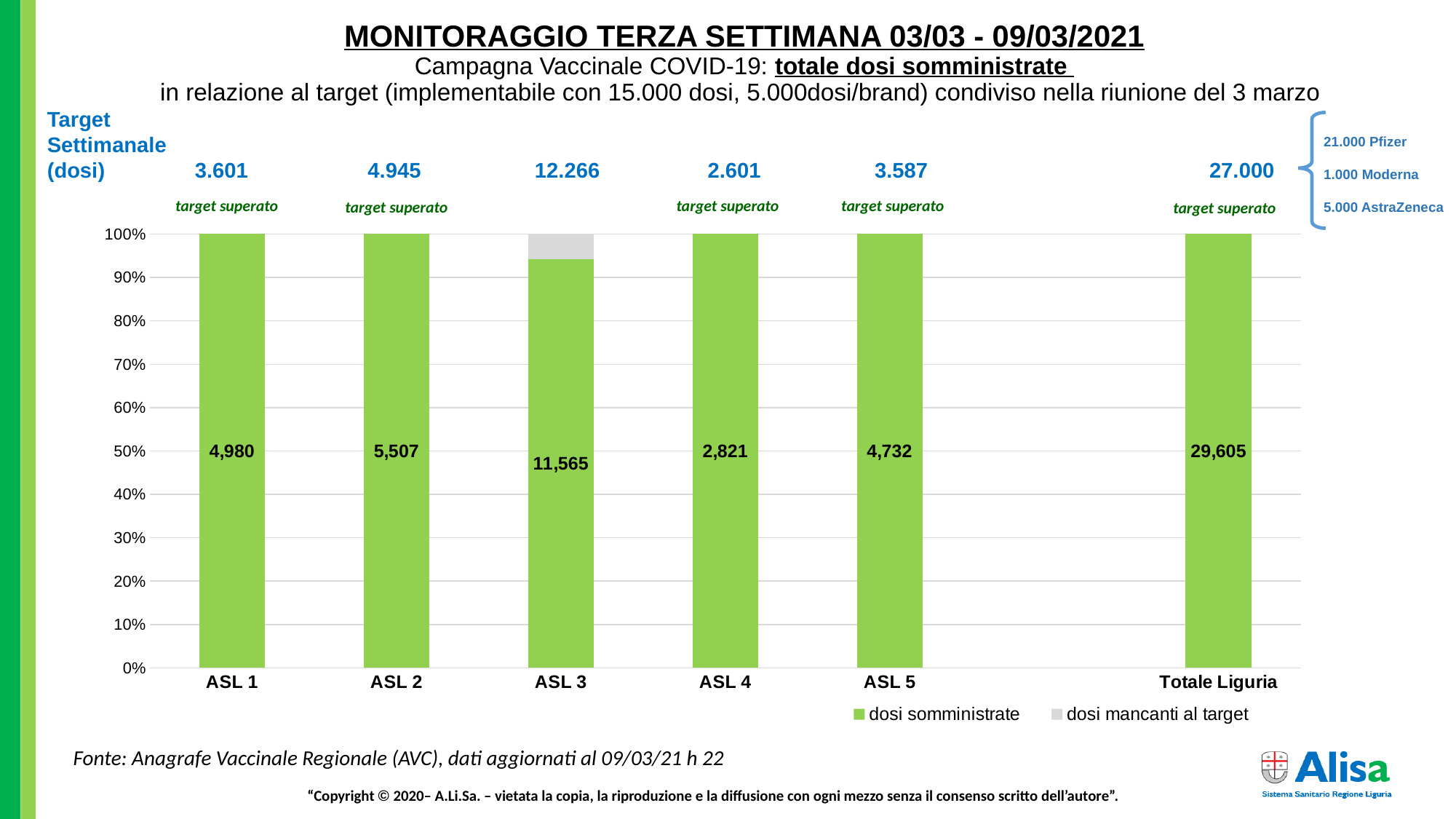
Among the five ASL categories, which has the lowest number of dosi somministrate? ASL 4 What is the value of dosi somministrate shown for ASL 3? 11,565 What kind of chart is shown on the slide? Stacked bar chart How many series does the chart legend list? 2 Which has more dosi somministrate, ASL 1 or ASL 5? ASL 1 Among the five ASL categories, which has the highest number of dosi somministrate? ASL 3 What is the difference in dosi somministrate between ASL 3 and ASL 2? 6,058 How many categories are shown on the x axis of the chart? 6 Is the dosi somministrate share of the ASL 3 bar greater or less than 90%? greater What is the value of dosi somministrate shown for ASL 1? 4,980 What is the difference in dosi somministrate between ASL 2 and ASL 1? 527 What is the value of dosi somministrate shown for Totale Liguria? 29,605